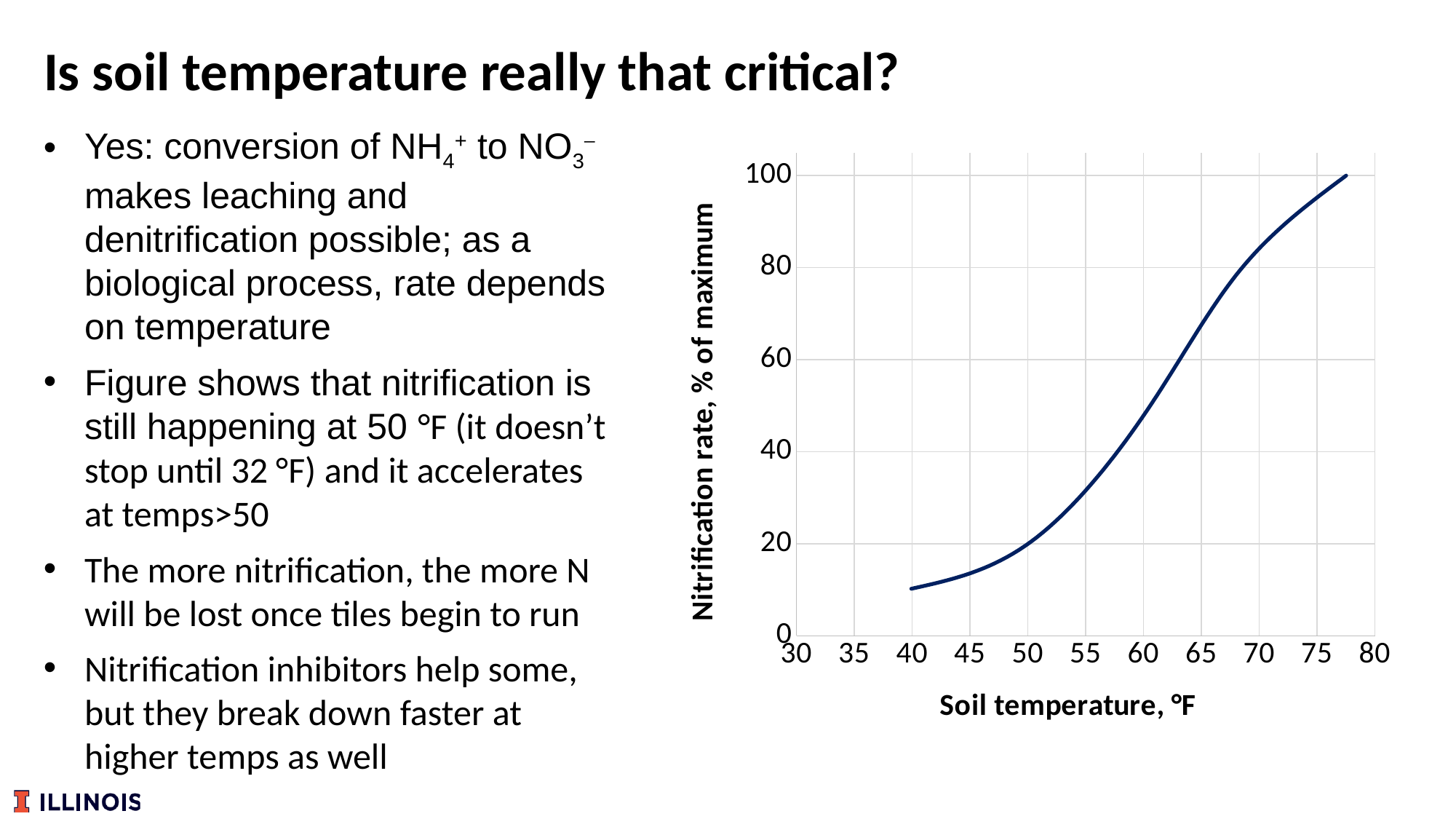
Is the nitrification rate at 60 °F greater or less than 40? greater Does the nitrification rate rise or fall as soil temperature increases along the x axis? rise Is the nitrification rate at 65 °F greater or less than 60? greater Is the nitrification rate at 75 °F greater or less than 80? greater What is the highest nitrification rate value reached by the line? 100 Is the nitrification rate higher at 70 °F or at 50 °F? 70 °F What kind of chart is shown on the slide? line chart What is the label of the y axis? Nitrification rate, % of maximum What is the label of the x axis? Soil temperature, °F